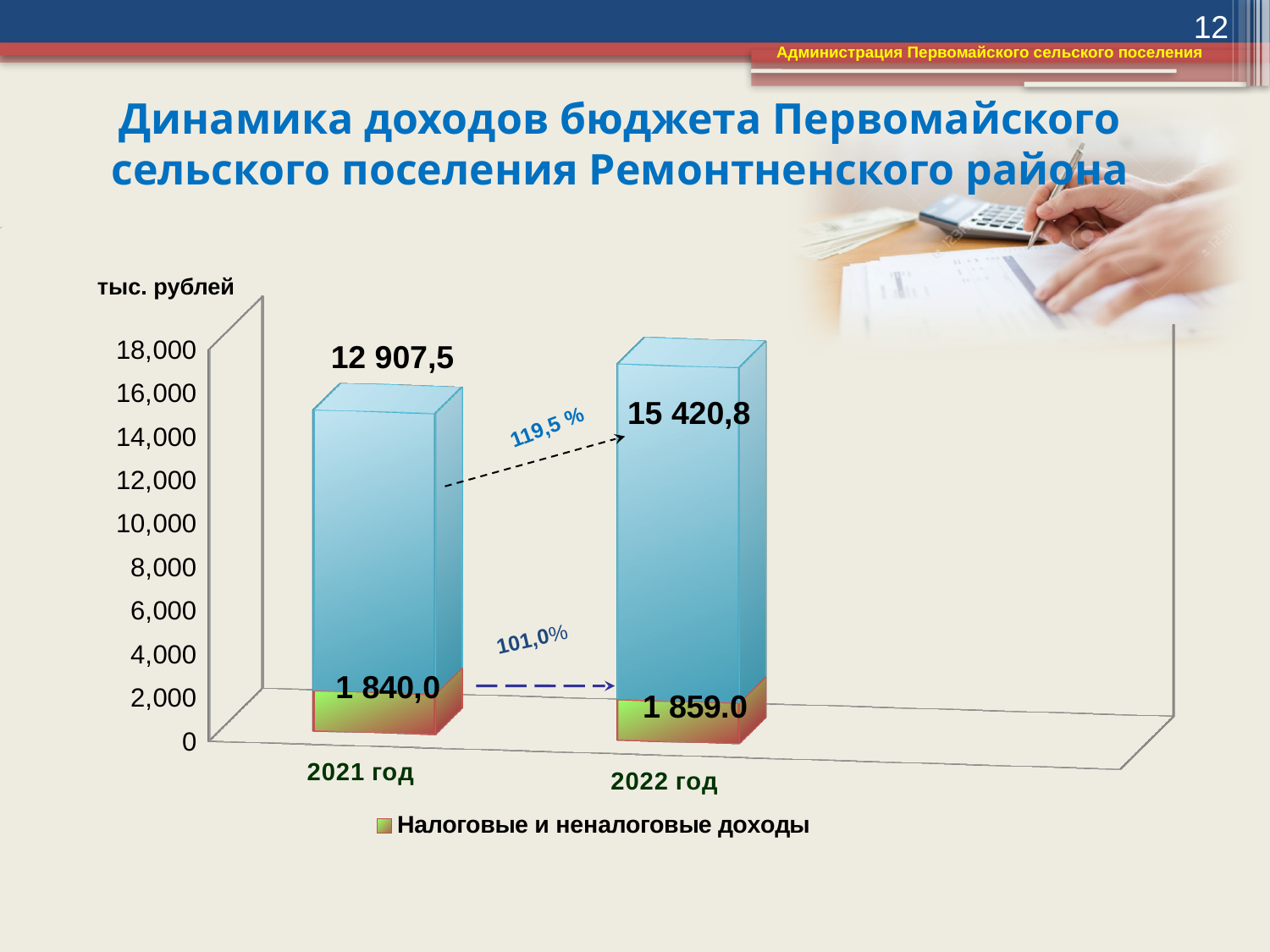
Which year has the higher value of Налоговые и неналоговые доходы? 2022 год What is the value of Налоговые и неналоговые доходы for 2022 год? 1 859.0 What value is labelled on the upper (blue) part of the bar for 2022 год? 15 420,8 What is the difference between the upper (blue) bar values for 2022 год (15 420,8) and 2021 год (12 907,5)? 2 513,3 By how much did Налоговые и неналоговые доходы change from 2021 год (1 840,0) to 2022 год (1 859.0)? 19,0 What is the value of Налоговые и неналоговые доходы for 2021 год? 1 840,0 What unit is indicated above the vertical axis of the chart? тыс. рублей Do the bar values rise or fall from 2021 год to 2022 год? rise How many years (categories) are shown on the x axis of the chart? 2 What value is labelled on the upper (blue) part of the bar for 2021 год? 12 907,5 What kind of chart is shown on the slide? bar chart Which year has the larger value labelled on the upper (blue) part of the bar, 2021 год or 2022 год? 2022 год